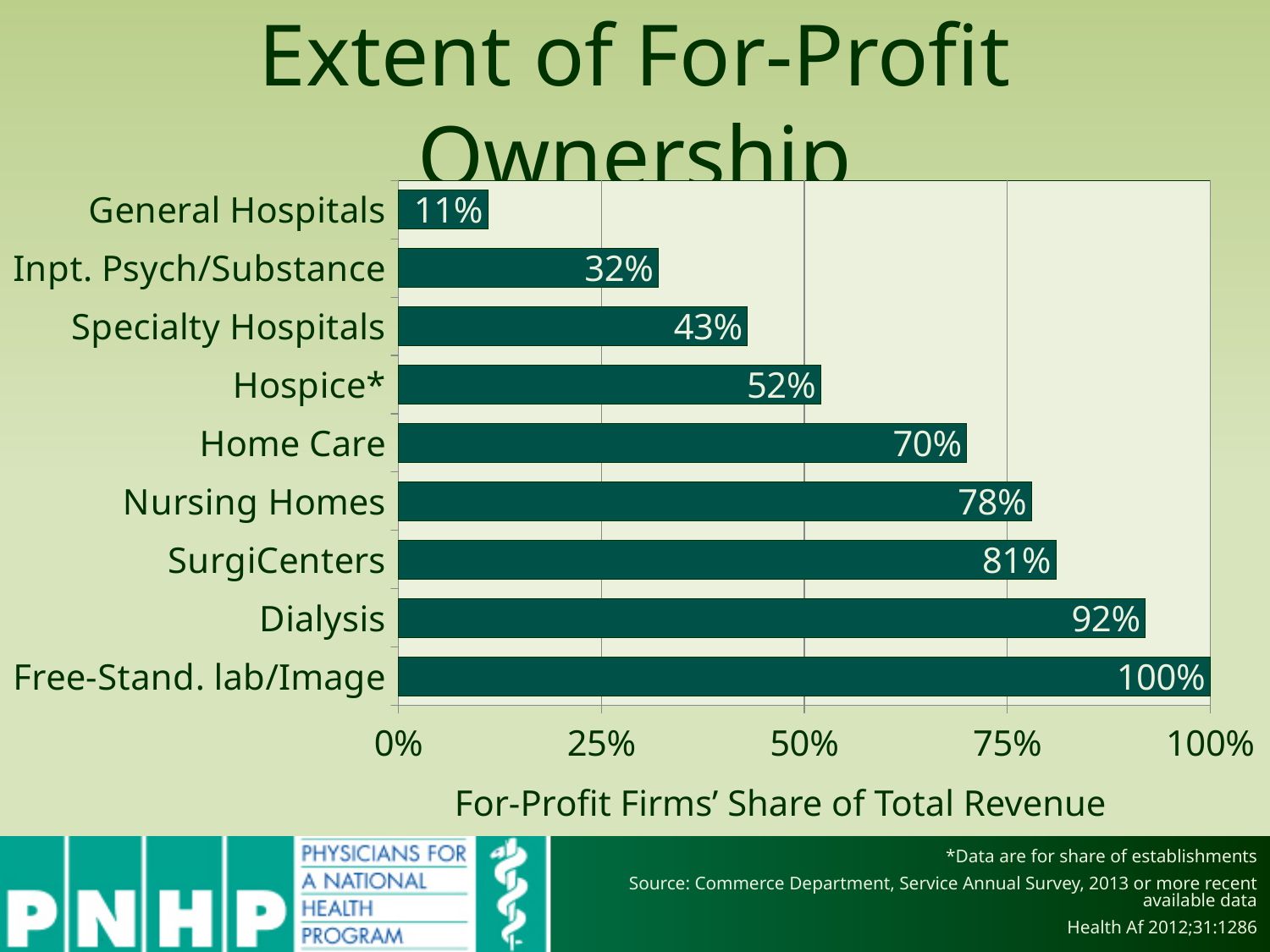
What is the label on the horizontal axis of the chart? For-Profit Firms' Share of Total Revenue What is the value shown for Nursing Homes? 78% What is the difference between the values for Dialysis and SurgiCenters? 11% Which is larger, the value for Home Care or the value for Hospice*? Home Care What kind of chart is shown on the slide? bar chart Which category has the highest for-profit share? Free-Stand. lab/Image What is the value shown for Inpt. Psych/Substance? 32% What is the difference between the values for Hospice* and Specialty Hospitals? 9% Which category has the lowest for-profit share? General Hospitals How many categories are shown in the chart? 9 What is the for-profit share of total revenue for Home Care? 70% Is the value for Specialty Hospitals greater or less than 50%? less